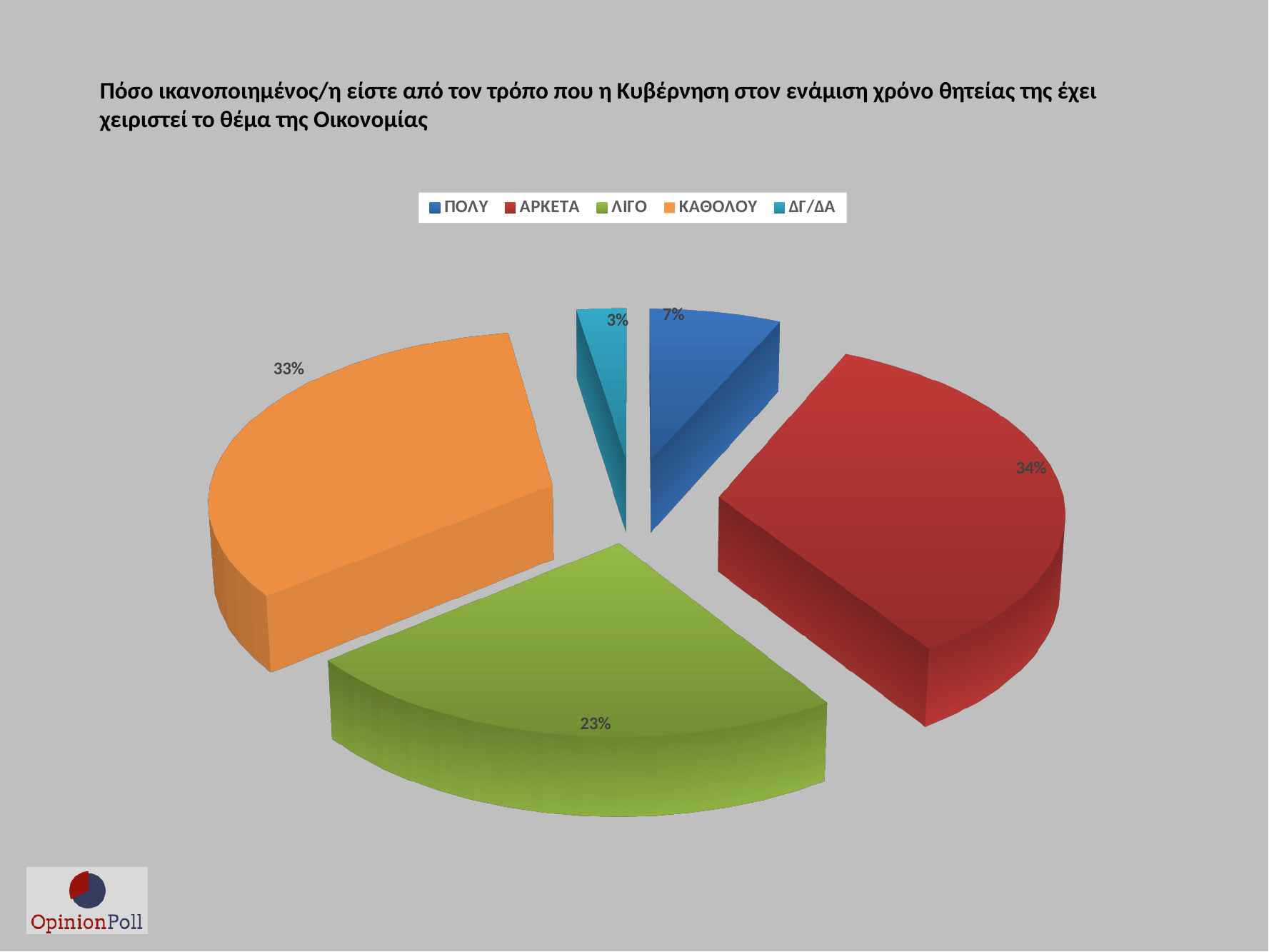
How many categories does the legend list? 5 What is the difference in percentage points between ΚΑΘΟΛΟΥ and ΠΟΛΥ? 26 What kind of chart is shown on the slide? Pie chart What percentage of respondents answered ΑΡΚΕΤΑ? 34% What colour is the slice for ΚΑΘΟΛΟΥ? Orange What percentage of respondents answered ΚΑΘΟΛΟΥ? 33% What percentage of respondents answered ΛΙΓΟ? 23% What percentage of respondents answered ΠΟΛΥ? 7% Which response category has the smallest share of the pie? ΔΓ/ΔΑ What is the difference in percentage points between ΑΡΚΕΤΑ and ΛΙΓΟ? 11 Which is larger, the share for ΛΙΓΟ or the share for ΠΟΛΥ? ΛΙΓΟ What percentage of respondents answered ΔΓ/ΔΑ? 3%